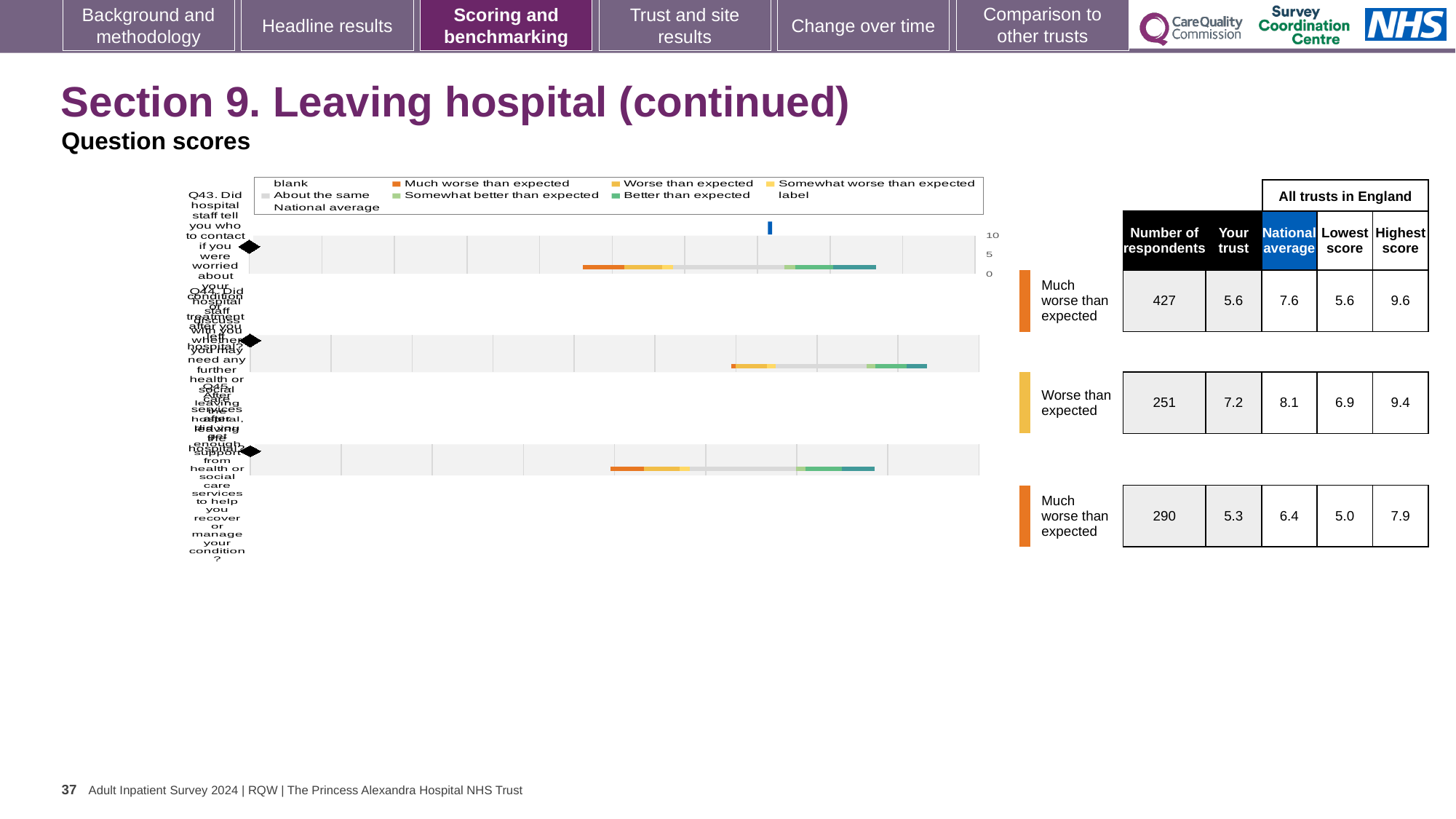
Which question row has the larger 'Your trust' score, the first row or the second row? the second row What is the national average for the first question row (Q43)? 7.6 What is the highest score among all trusts in England for the third question row? 7.9 What benchmark rating is shown for the first question row (Q43)? Much worse than expected How many survey questions are plotted in the chart? 3 What benchmark rating is shown for the second question row? Worse than expected How many respondents answered the second question row? 251 What kind of chart is shown on the slide? bar chart Which question row has the lowest 'Your trust' score? the third row Which question row has the highest number of respondents? the first row (Q43) What is the 'Your trust' score for Q43 (Did hospital staff tell you who to contact if you were worried about your condition or treatment after you left hospital?)? 5.6 What is the difference between the national average and the trust's score for the first question row (Q43)? 2.0